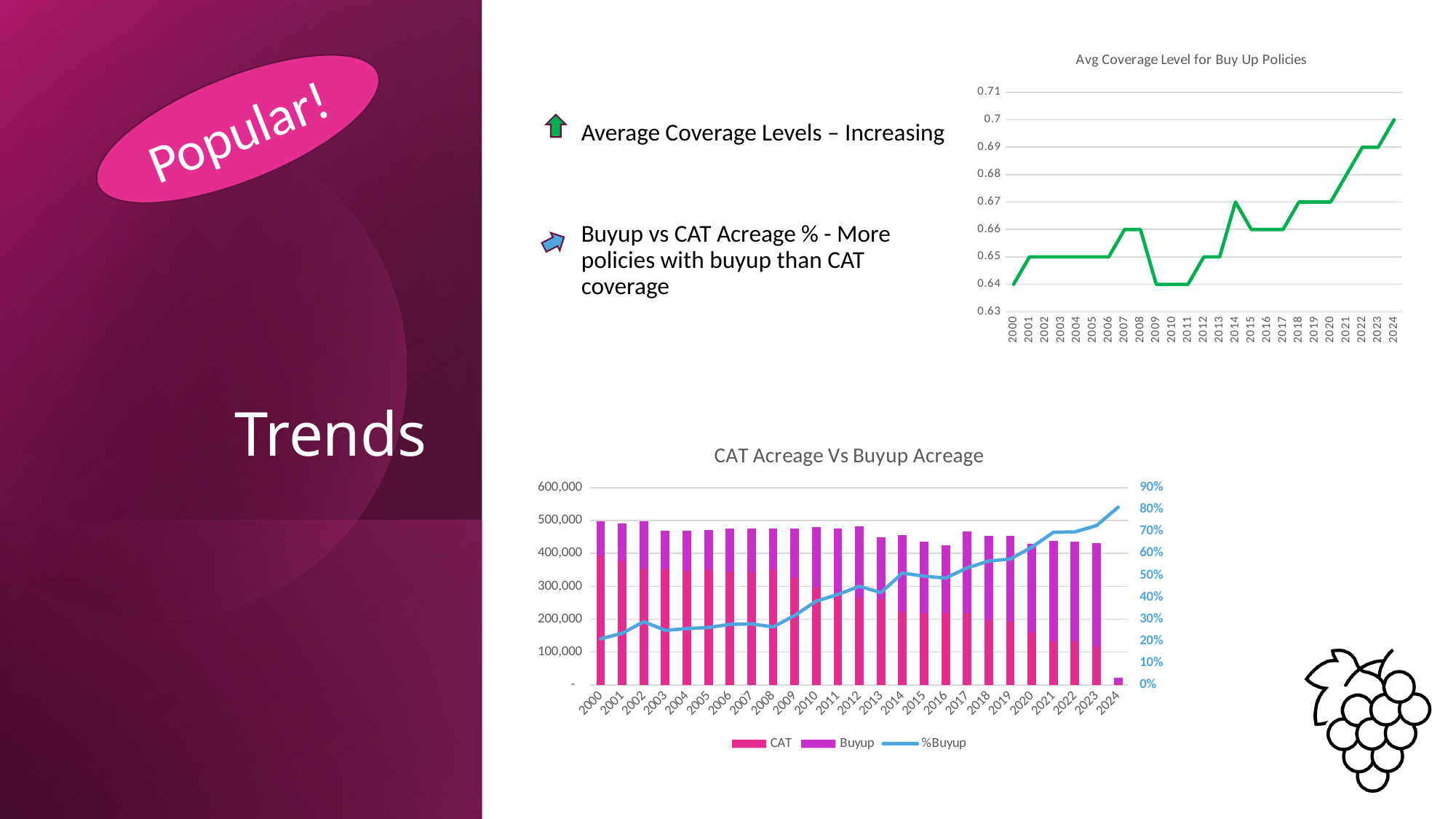
How many series does the legend of the 'CAT Acreage Vs Buyup Acreage' chart list? 3 In the 'CAT Acreage Vs Buyup Acreage' chart, does the %Buyup line generally rise or fall from 2000 to 2024? rise In the 'CAT Acreage Vs Buyup Acreage' chart, which series is shown in pink/magenta bars at the bottom of each stack? CAT In the 'Avg Coverage Level for Buy Up Policies' chart, what is the value for 2024? 0.7 In the 'Avg Coverage Level for Buy Up Policies' chart, which year has the highest value? 2024 In the 'CAT Acreage Vs Buyup Acreage' chart, is the %Buyup value for 2024 greater or less than 70%? greater What type of chart is the 'Avg Coverage Level for Buy Up Policies' chart? line chart In the 'CAT Acreage Vs Buyup Acreage' chart, is the %Buyup value for 2000 greater or less than 30%? less In the 'Avg Coverage Level for Buy Up Policies' chart, do the values generally rise or fall from 2000 to 2024? rise In the 'Avg Coverage Level for Buy Up Policies' chart, what is the difference between the 2024 value and the 2000 value? 0.06 In the 'Avg Coverage Level for Buy Up Policies' chart, what is the value for 2014? 0.67 In the 'Avg Coverage Level for Buy Up Policies' chart, what is the value for 2000? 0.64